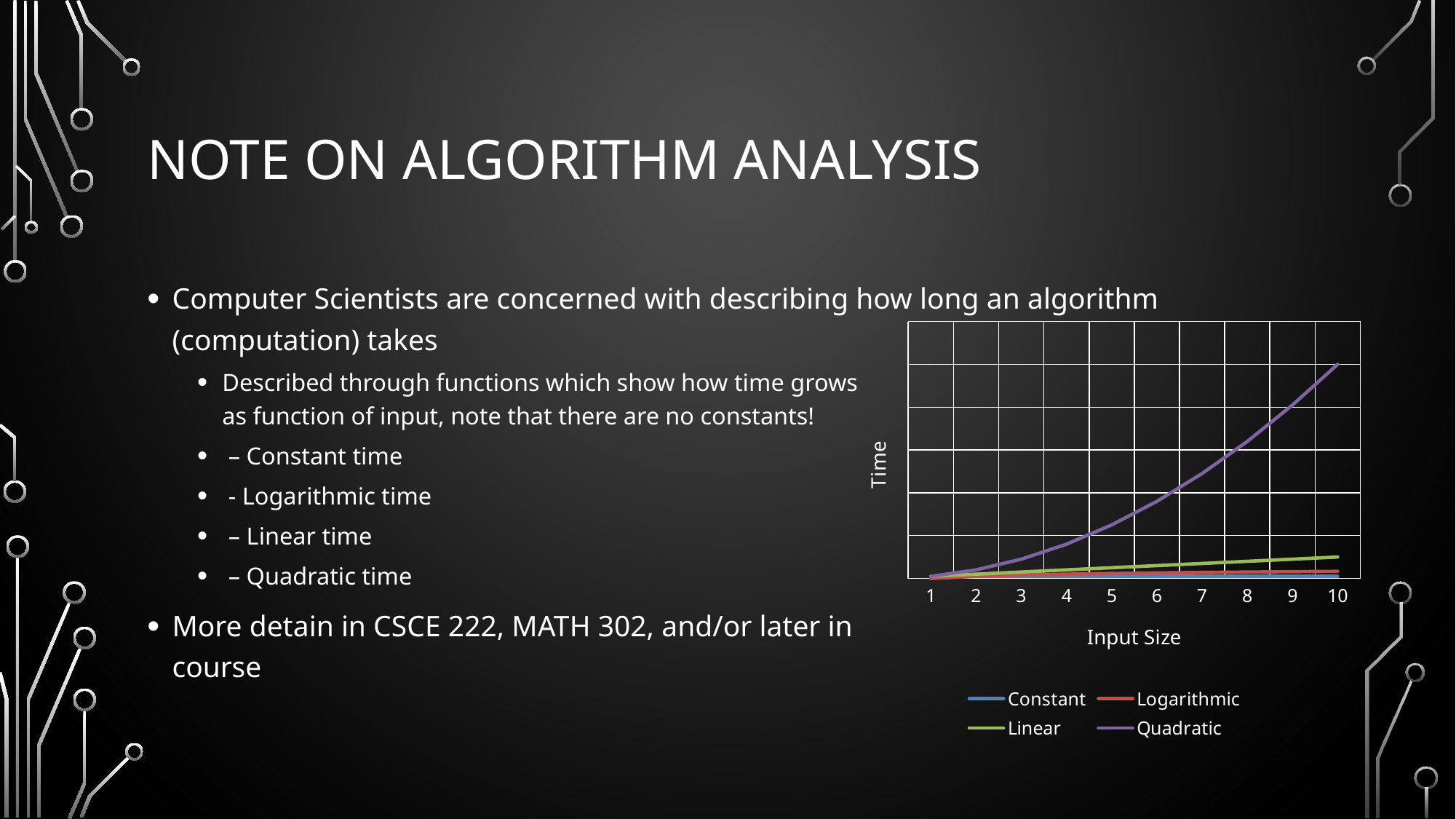
At input size 10, which series has the larger value, Linear or Constant? Linear What is the label of the x axis of the chart? Input Size How many input size values are marked along the x axis of the chart? 10 Does the Quadratic series rise or fall as input size increases from 1 to 10? rises What is the label of the y axis of the chart? Time What kind of chart is shown on the slide? line chart Which series has the highest value at input size 10? Quadratic Does the Linear series rise or fall along the x axis? rises How many series does the chart's legend list? 4 At input size 10, which series has the larger value, Linear or Quadratic? Quadratic